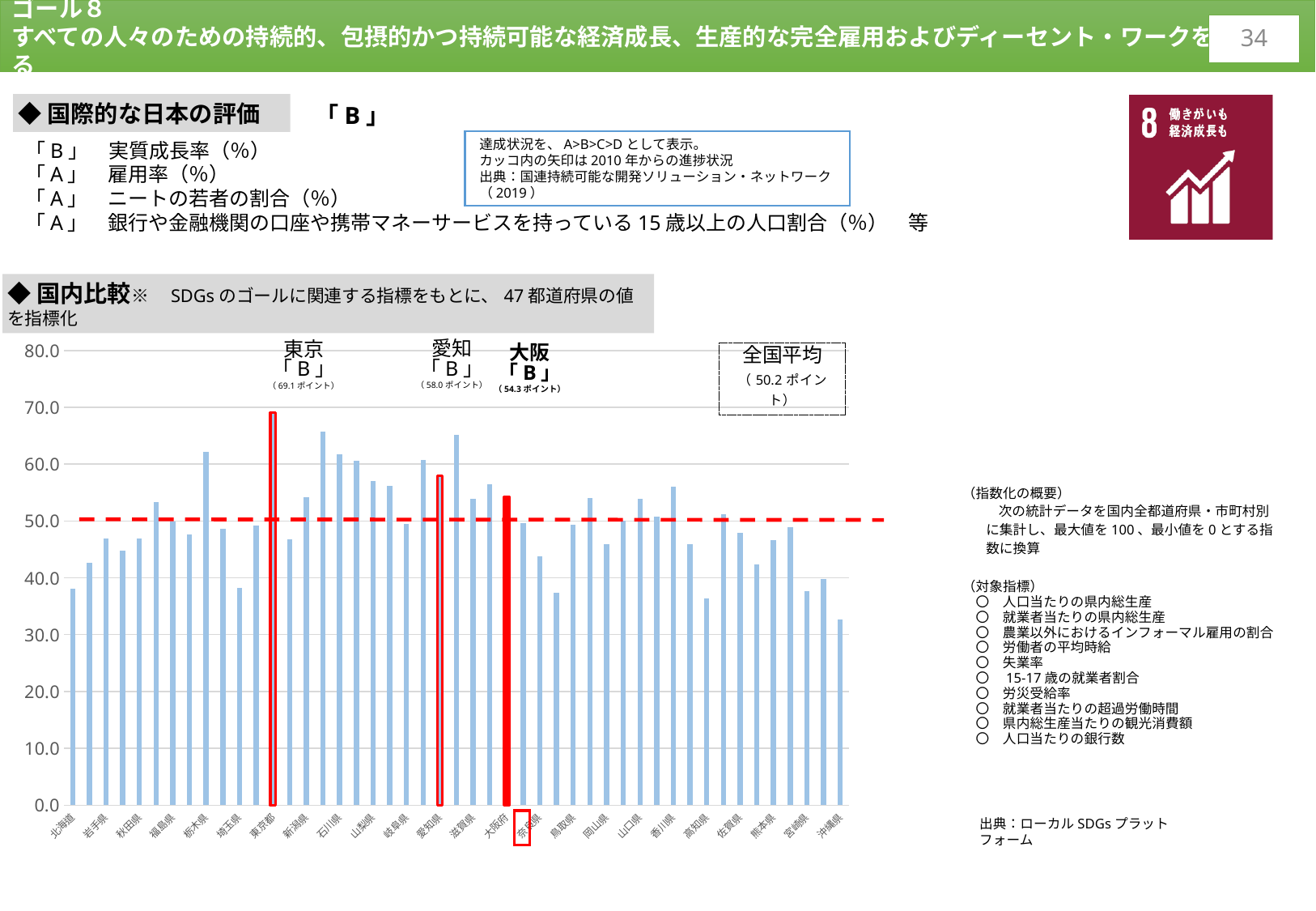
Is the value for 北海道 greater or less than 40.0? less Which prefecture has the lowest bar on the chart? 沖縄県 By how much does 大阪 exceed the 全国平均? 4.1 ポイント What is the value shown for 愛知 on the 国内比較 bar chart? 58.0 ポイント What is the difference between the values for 東京 and 大阪? 14.8 ポイント Which prefecture has the highest bar on the chart? 東京都 Which has the higher value, 東京 or 愛知? 東京 What kind of chart is used for the 国内比較 section? bar chart What is the 全国平均 value indicated on the chart? 50.2 ポイント What is the value shown for 大阪 on the 国内比較 bar chart? 54.3 ポイント What is the value shown for 東京 on the 国内比較 bar chart? 69.1 ポイント What does the red dashed horizontal line on the chart represent? 全国平均